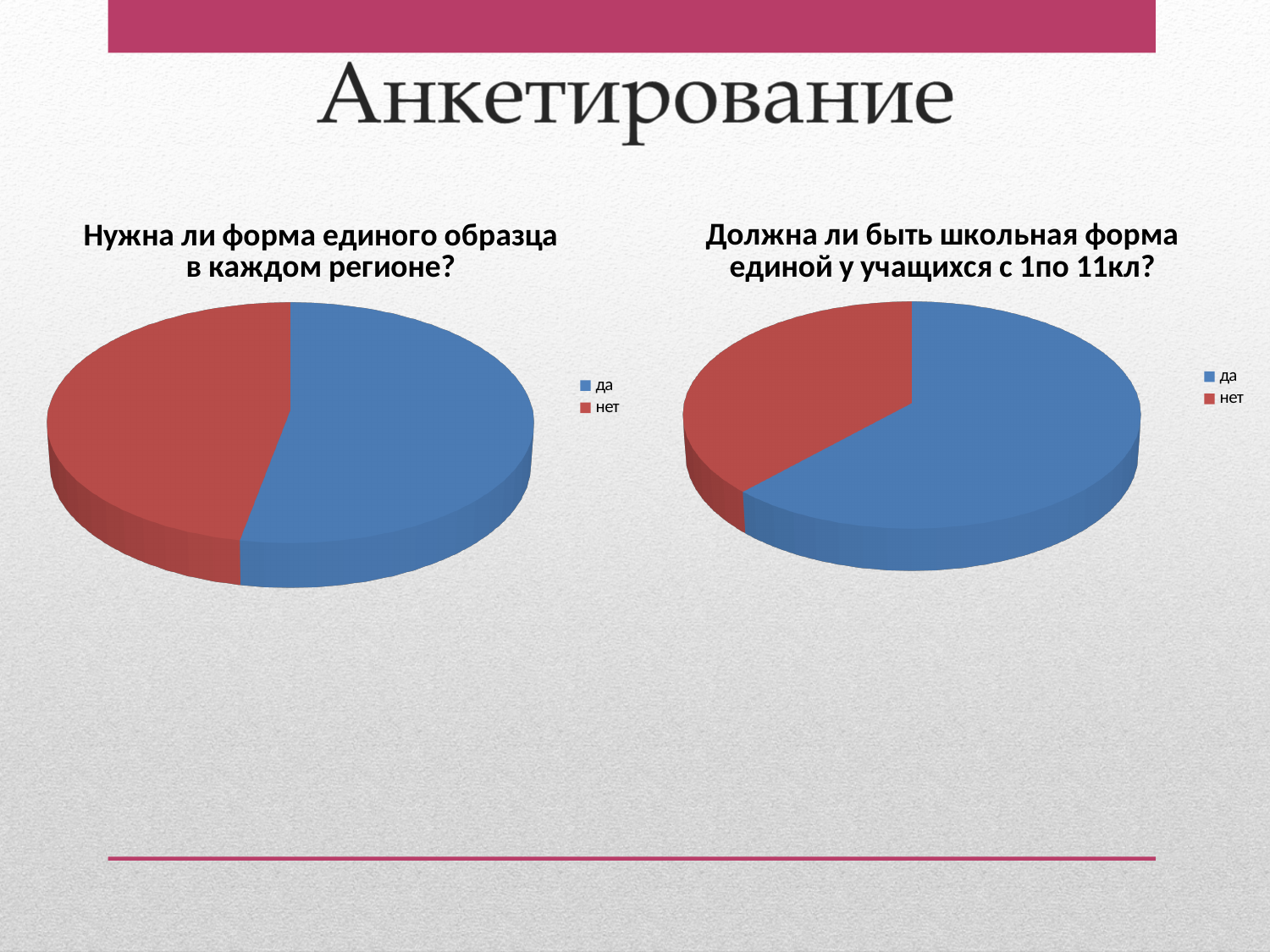
In the right chart "Должна ли быть школьная форма единой у учащихся с 1по 11кл?", which slice is the smallest? нет In the right chart "Должна ли быть школьная форма единой у учащихся с 1по 11кл?", which slice is larger, "да" or "нет"? да What are the legend entries of the right chart "Должна ли быть школьная форма единой у учащихся с 1по 11кл?"? да, нет In the right chart "Должна ли быть школьная форма единой у учащихся с 1по 11кл?", which slice is the largest? да What kind of chart is the right chart titled "Должна ли быть школьная форма единой у учащихся с 1по 11кл?"? pie chart What kind of chart is the left chart titled "Нужна ли форма единого образца в каждом регионе?"? pie chart How many slices does the left chart "Нужна ли форма единого образца в каждом регионе?" have? 2 In the left chart "Нужна ли форма единого образца в каждом регионе?", what colour is the "нет" slice? red How many entries does the legend of the left chart "Нужна ли форма единого образца в каждом регионе?" list? 2 How many slices does the right chart "Должна ли быть школьная форма единой у учащихся с 1по 11кл?" have? 2 In the left chart "Нужна ли форма единого образца в каждом регионе?", which slice is larger, "да" or "нет"? да